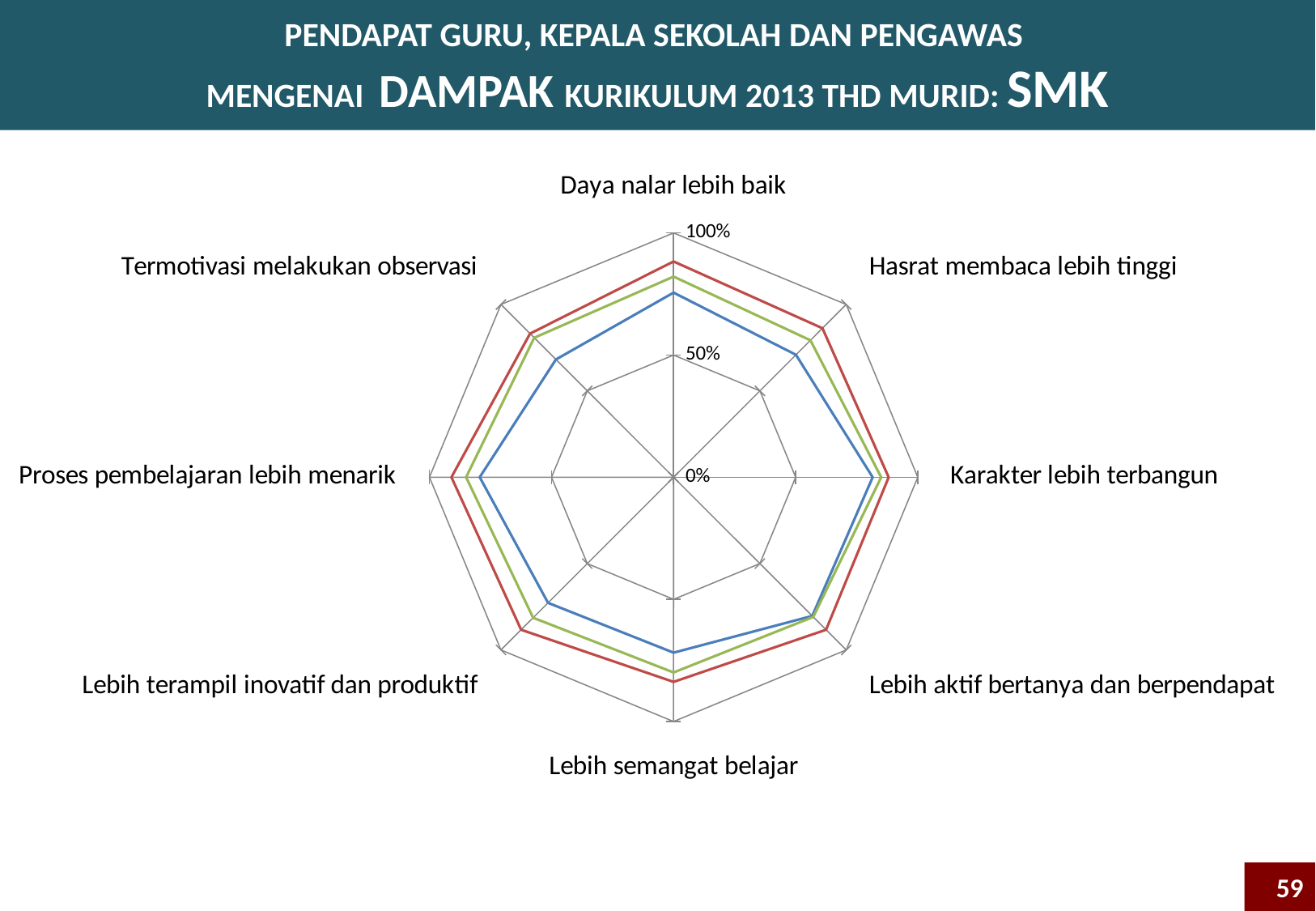
How many categories (axes) does the radar chart have? 8 Is the value of the red line for 'Karakter lebih terbangun' greater or less than 100%? less Is the value of the green line for 'Lebih semangat belajar' greater or less than 50%? greater For 'Proses pembelajaran lebih menarik', which line has the larger value, the red line or the blue line? The red line What kind of chart is shown on the slide? Radar chart Is the value of the blue line for 'Daya nalar lebih baik' greater or less than 50%? greater For 'Termotivasi melakukan observasi', which line has the larger value, the green line or the blue line? The green line What is the highest percentage tick shown on the radar chart's axis? 100% How many data series (lines) are plotted on the radar chart? 3 Which category label appears at the top of the radar chart? Daya nalar lebih baik